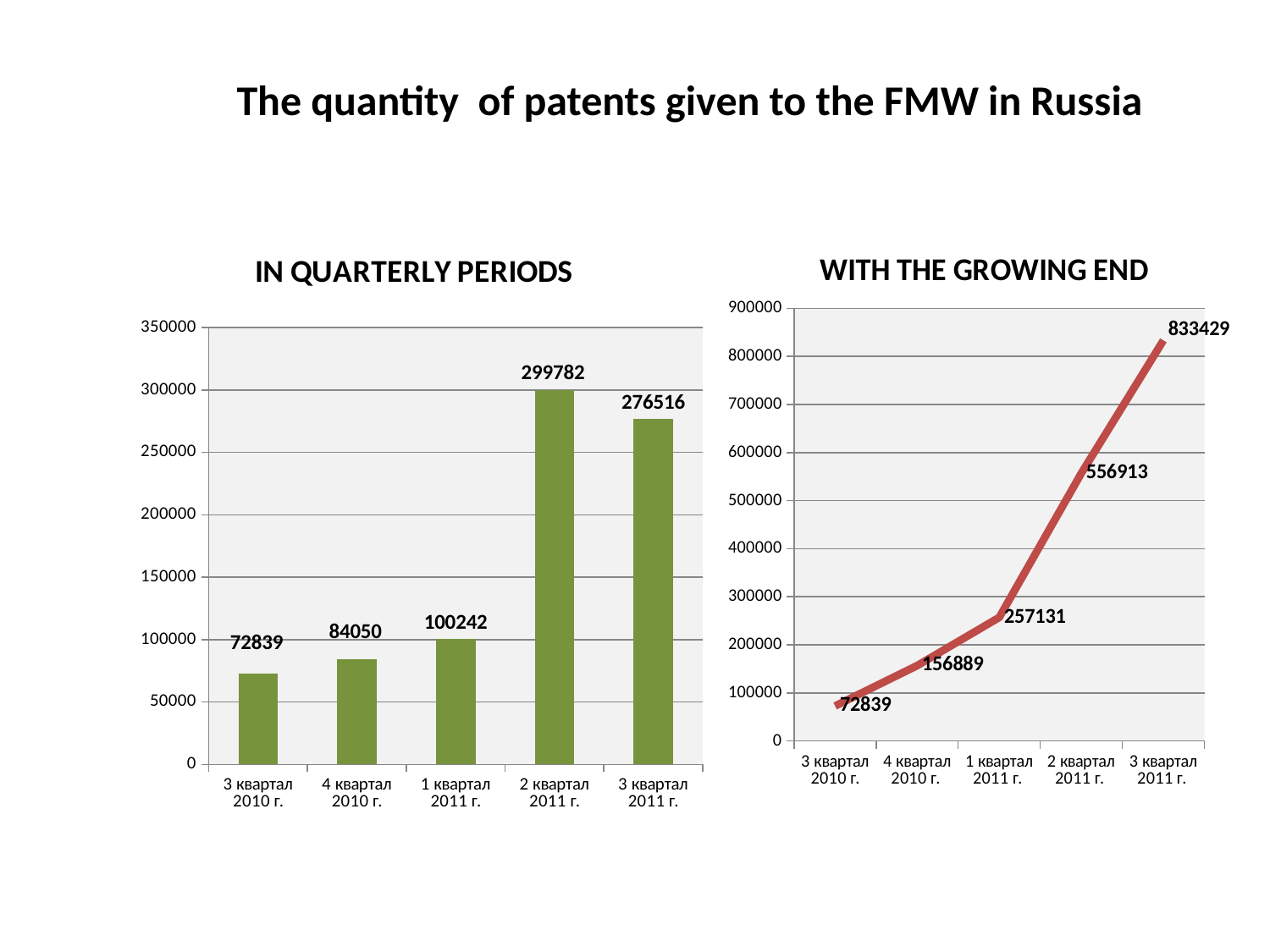
In the 'WITH THE GROWING END' chart, what is the value for 1 квартал 2011 г.? 257131 What kind of chart is the 'WITH THE GROWING END' chart? Line chart In the 'WITH THE GROWING END' chart, what is the difference between the values for 2 квартал 2011 г. and 1 квартал 2011 г.? 299782 In the 'WITH THE GROWING END' chart, what is the value for 3 квартал 2011 г.? 833429 In the 'IN QUARTERLY PERIODS' chart, which quarter has the highest value? 2 квартал 2011 г. What kind of chart is the 'IN QUARTERLY PERIODS' chart? Bar chart In the 'WITH THE GROWING END' chart, do the values rise or fall from left to right? Rise In the 'IN QUARTERLY PERIODS' chart, what is the value for 2 квартал 2011 г.? 299782 In the 'IN QUARTERLY PERIODS' chart, what is the value for 4 квартал 2010 г.? 84050 In the 'IN QUARTERLY PERIODS' chart, which quarter has the lowest value? 3 квартал 2010 г. In the 'IN QUARTERLY PERIODS' chart, how many bars are there? 5 In the 'IN QUARTERLY PERIODS' chart, what is the difference between the values for 2 квартал 2011 г. and 3 квартал 2011 г.? 23266